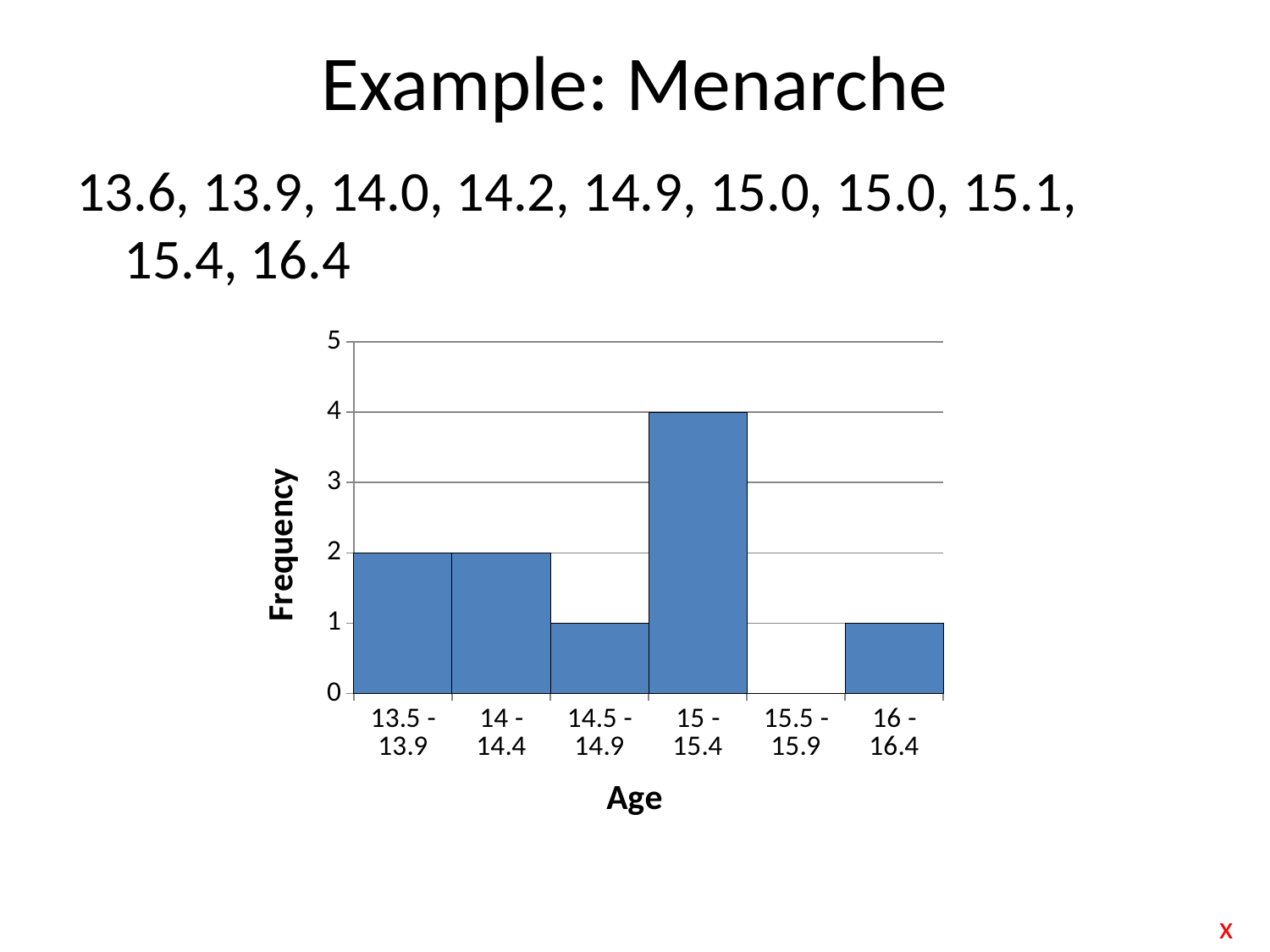
What is the frequency for the 15 - 15.4 age bin? 4 What kind of chart is shown on the slide? Bar chart Which age bin has the highest frequency? 15 - 15.4 Which has a higher frequency, the 14 - 14.4 bin or the 14.5 - 14.9 bin? 14 - 14.4 What is the frequency for the 14.5 - 14.9 age bin? 1 What is the frequency for the 13.5 - 13.9 age bin? 2 Which age bin has the lowest frequency? 15.5 - 15.9 What is the frequency for the 15.5 - 15.9 age bin? 0 What is the label of the vertical axis? Frequency What is the difference in frequency between the 15 - 15.4 bin and the 16 - 16.4 bin? 3 What is the label of the horizontal axis? Age How many age bins are shown on the x axis? 6